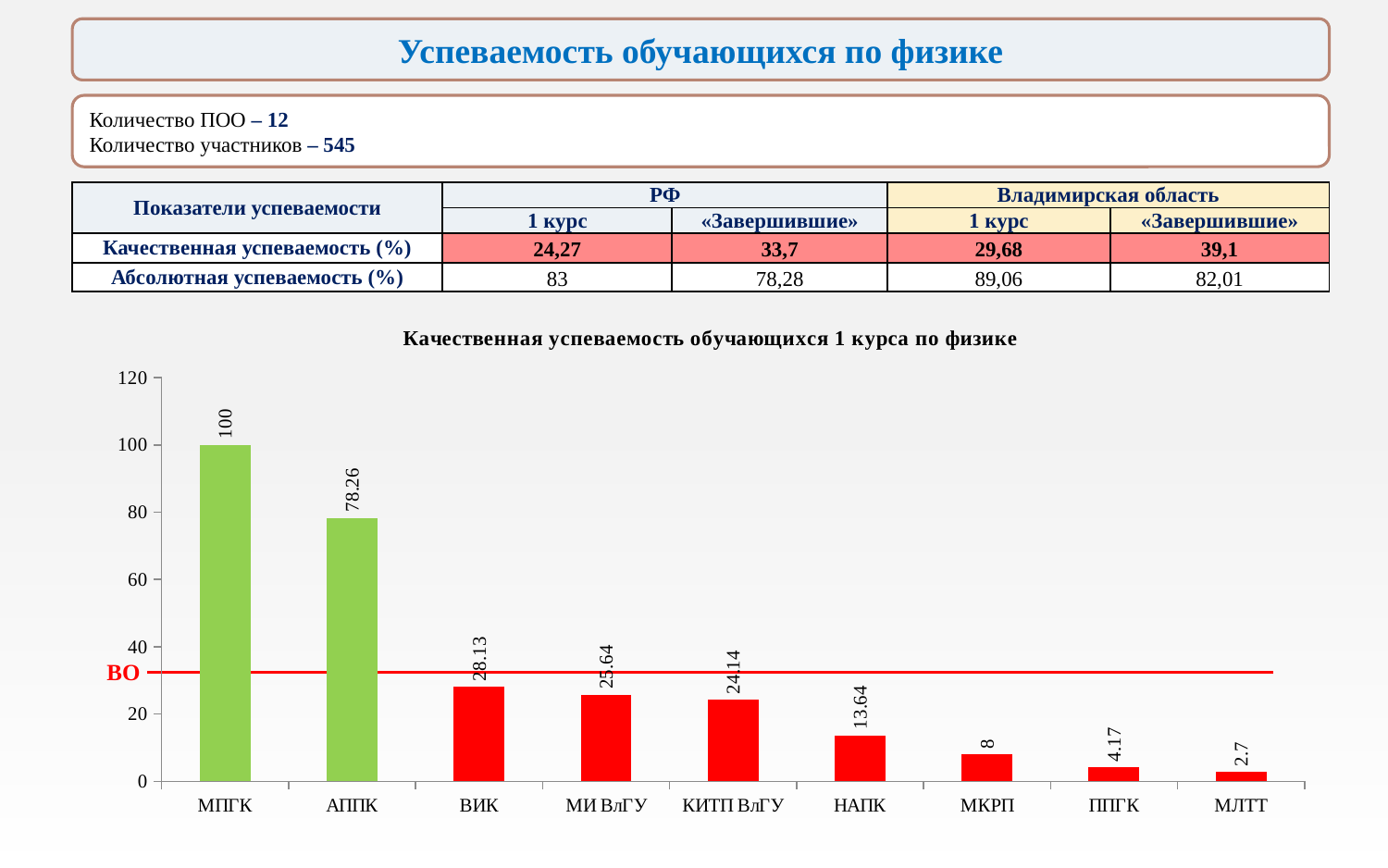
What is the title of the chart? Качественная успеваемость обучающихся 1 курса по физике What is the value for АППК in the chart? 78.26 What is the value for МПГК in the chart? 100 What is the value for НАПК in the chart? 13.64 Which category has the highest value in the chart? МПГК Which is larger, the value for ВИК or the value for МИ ВлГУ? ВИК Which category has the lowest value in the chart? МЛТТ What kind of chart is shown on the slide? bar chart Is the value for МКРП greater or less than 20? less What is the value for МЛТТ in the chart? 2.7 How many categories are shown on the x axis of the chart? 9 What is the difference between the values for МПГК and АППК? 21.74